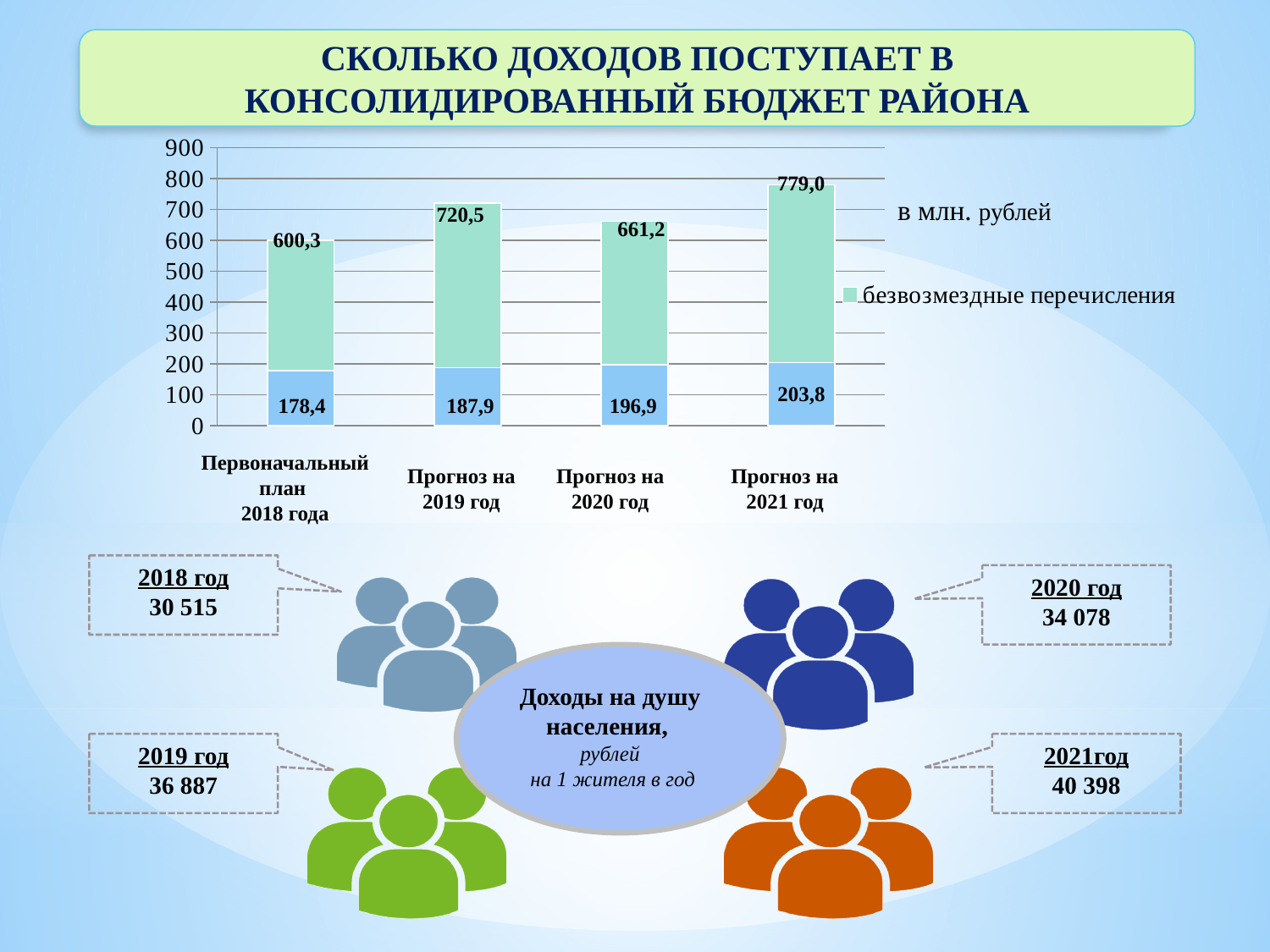
What is the total value of the bar for Прогноз на 2021 год? 779,0 Is the total for Прогноз на 2020 год greater or less than 700? less Do the values of the bottom (blue) segments rise or fall from 2018 to 2021? rise Which category has the lowest total bar? Первоначальный план 2018 года Which category has the highest total bar? Прогноз на 2021 год What is the difference between the total for Прогноз на 2021 год and the total for Первоначальный план 2018 года? 178,7 What is the value of the bottom (blue) segment of the bar for Первоначальный план 2018 года? 178,4 Which total is larger: Прогноз на 2019 год or Прогноз на 2020 год? Прогноз на 2019 год What series name is shown in the chart legend? безвозмездные перечисления How many categories are shown along the x axis of the bar chart? 4 What kind of chart is shown on the slide? stacked bar chart What is the value of the bottom (blue) segment of the bar for Прогноз на 2019 год? 187,9